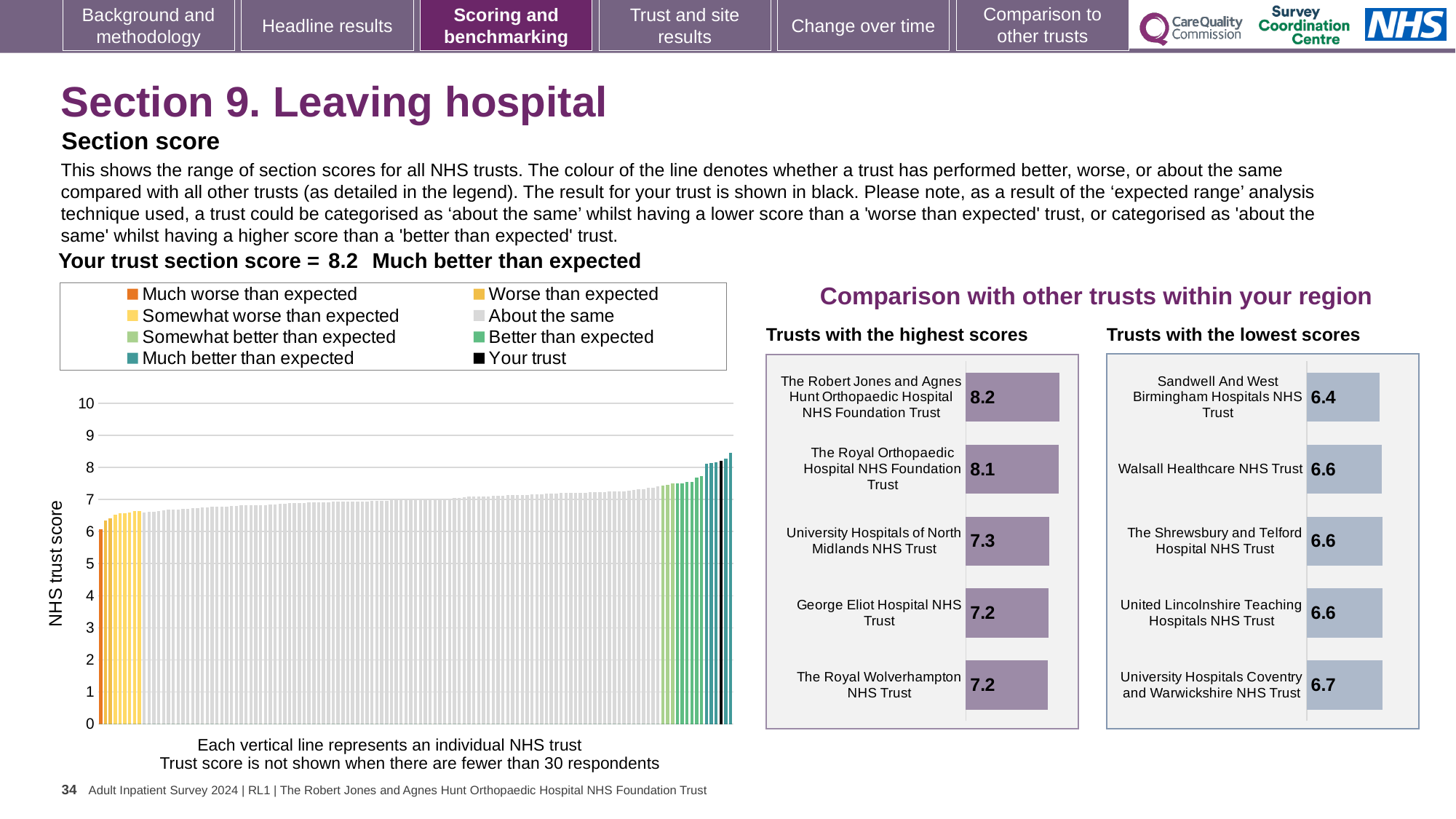
In the NHS trust score chart on the left, what is the section score for your trust (the black line)? 8.2 In the 'Trusts with the highest scores' chart, which trust has the highest score? The Robert Jones and Agnes Hunt Orthopaedic Hospital NHS Foundation Trust In the 'Trusts with the highest scores' chart, what is the score for The Royal Orthopaedic Hospital NHS Foundation Trust? 8.1 What kind of chart is the NHS trust score chart on the left of the slide? Bar chart In the 'Trusts with the highest scores' chart, what is the difference between the scores of The Robert Jones and Agnes Hunt Orthopaedic Hospital NHS Foundation Trust and University Hospitals of North Midlands NHS Trust? 0.9 In the 'Trusts with the lowest scores' chart, what is the score for Sandwell And West Birmingham Hospitals NHS Trust? 6.4 In the 'Trusts with the lowest scores' chart, which trust has the lowest score? Sandwell And West Birmingham Hospitals NHS Trust In the 'Trusts with the highest scores' chart, how many trusts are listed? 5 In the NHS trust score chart on the left, do the trust scores rise or fall from left to right? Rise In the 'Trusts with the lowest scores' chart, what is the difference between the scores of University Hospitals Coventry and Warwickshire NHS Trust and Sandwell And West Birmingham Hospitals NHS Trust? 0.3 In the 'Trusts with the lowest scores' chart, what is the score for University Hospitals Coventry and Warwickshire NHS Trust? 6.7 In the 'Trusts with the lowest scores' chart, which is larger: the score for Walsall Healthcare NHS Trust or the score for University Hospitals Coventry and Warwickshire NHS Trust? University Hospitals Coventry and Warwickshire NHS Trust